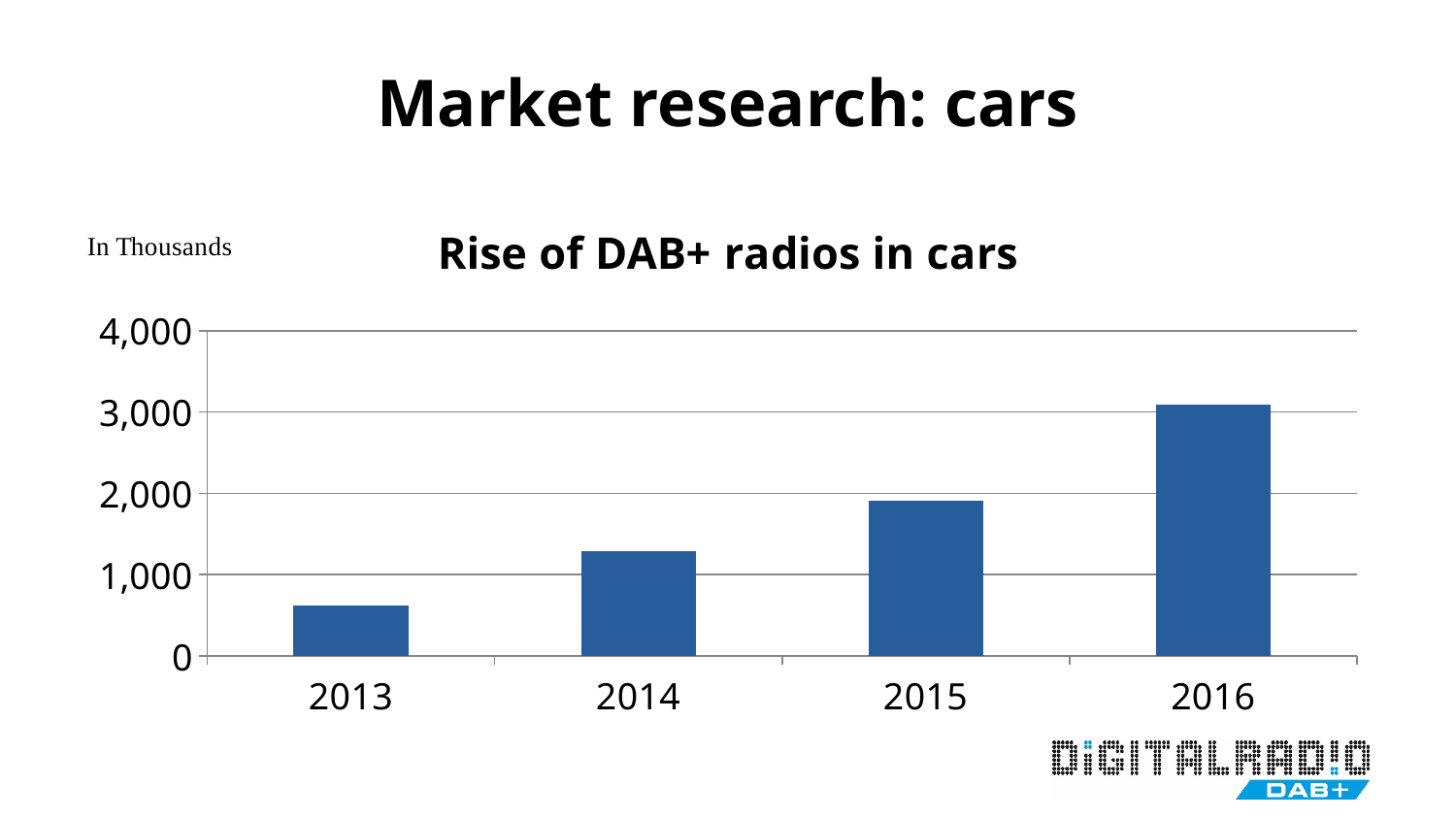
Is the value for 2015 greater or less than 1,000? greater What is the title of the chart? Rise of DAB+ radios in cars Which is larger, the value for 2014 or the value for 2015? 2015 Is the value for 2014 greater or less than 1,000? greater Is the value for 2013 greater or less than 1,000? less In what unit are the values on the chart expressed, according to the label above the axis? In Thousands Which year has the lowest value in the chart? 2013 Which year has the highest value in the chart? 2016 Do the values rise or fall from 2013 to 2016? rise What type of chart is shown on the slide? bar chart How many years are shown on the x axis of the chart? 4